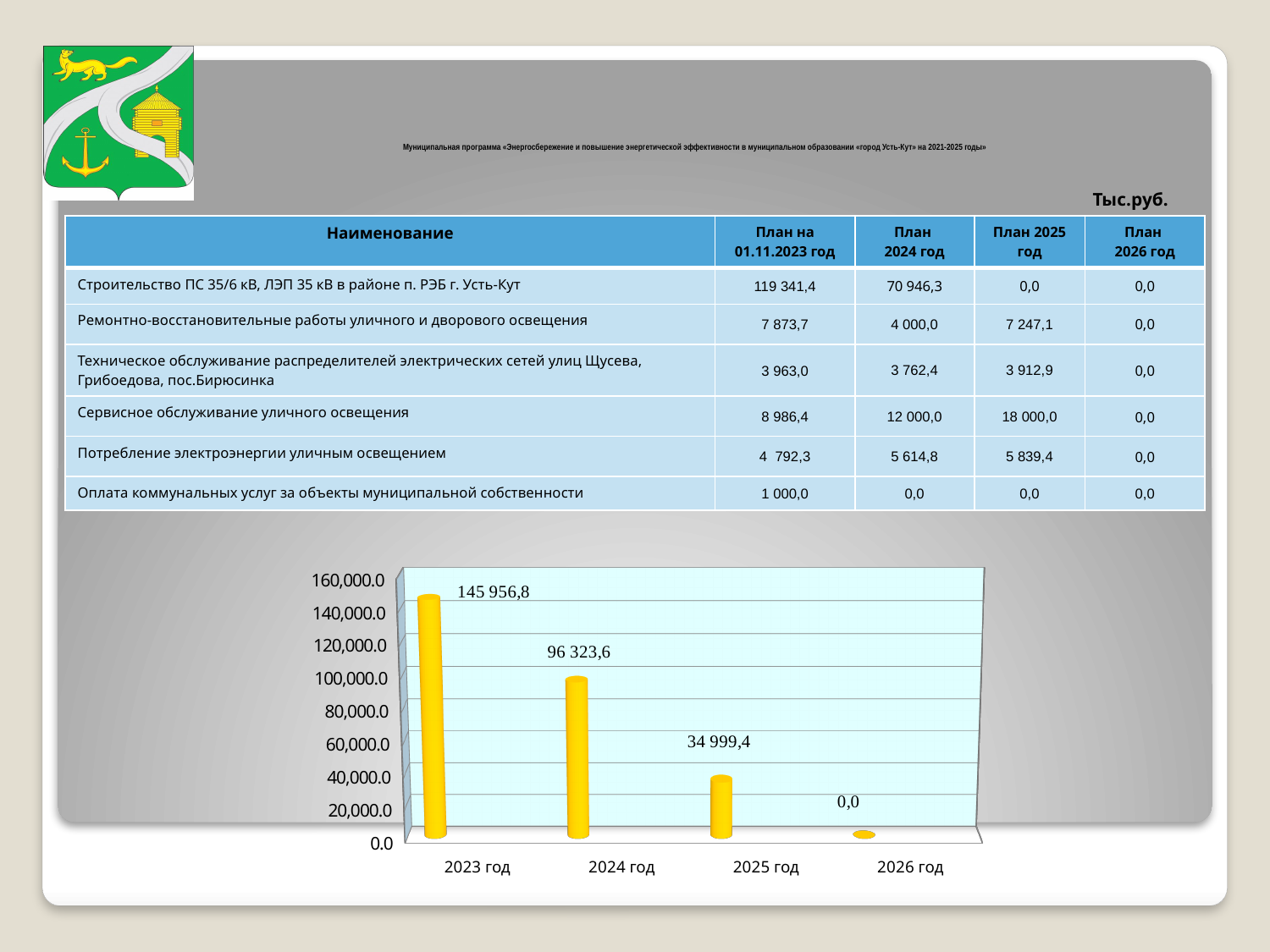
Which is larger in the bar chart, the value for 2024 год or the value for 2025 год? 2024 год What is the difference between the values for 2023 год and 2024 год in the bar chart? 49 633,2 Do the values in the bar chart rise or fall from 2023 год to 2026 год? Fall How many years (categories) are shown on the x axis of the bar chart? 4 What kind of chart is shown at the bottom of the slide? Bar chart Which year has the lowest value in the bar chart? 2026 год What is the value shown for 2023 год in the bar chart? 145 956,8 What is the value shown for 2024 год in the bar chart? 96 323,6 What is the value shown for 2026 год in the bar chart? 0,0 What is the value shown for 2025 год in the bar chart? 34 999,4 What is the difference between the values for 2024 год and 2025 год in the bar chart? 61 324,2 Which year has the highest value in the bar chart? 2023 год